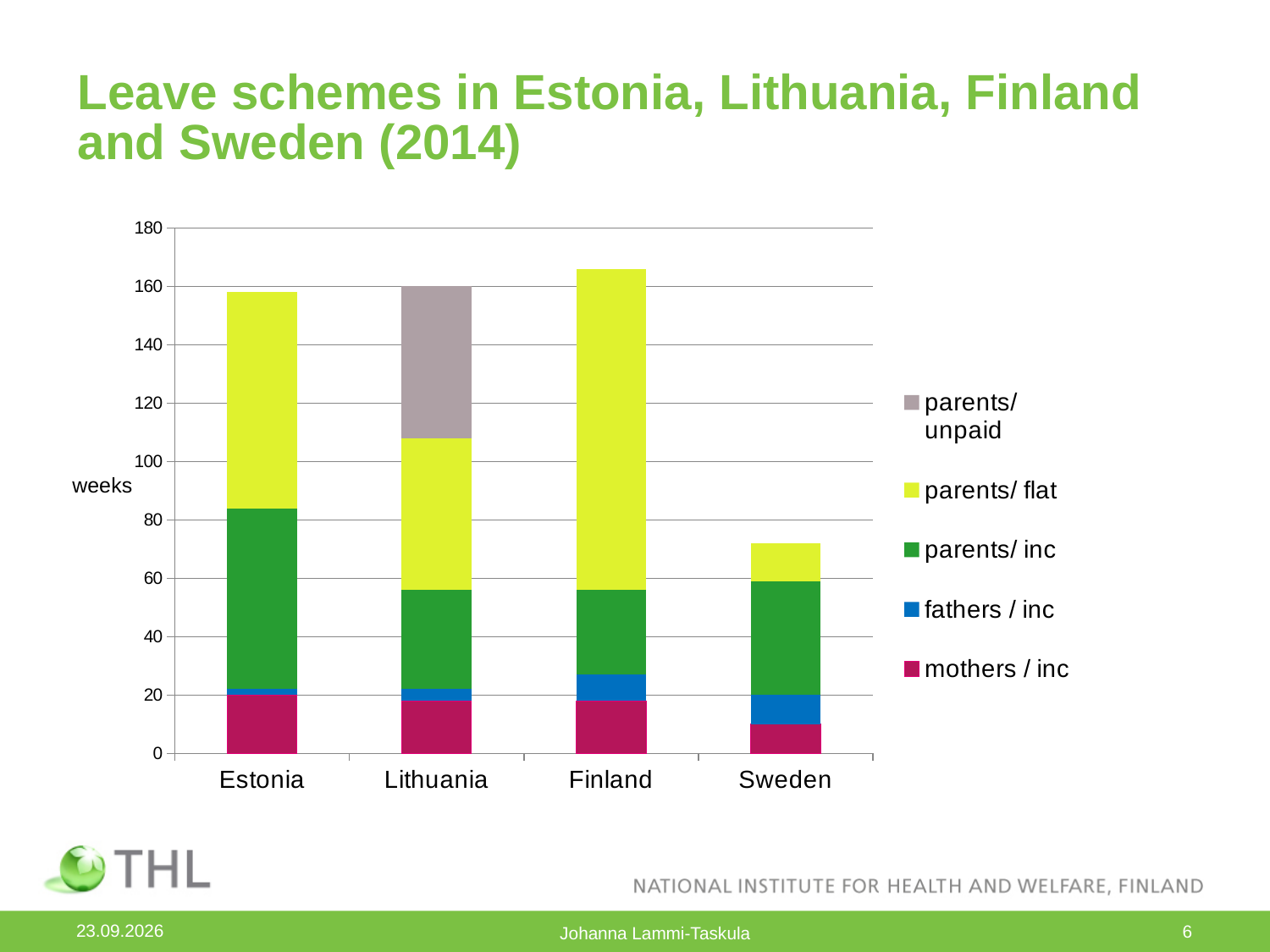
Which country has the tallest stacked bar (the most total weeks of leave)? Finland Which country has the shortest stacked bar (the fewest total weeks of leave)? Sweden What unit is labelled on the vertical axis of the chart? weeks Is the 'parents/ inc' segment larger for Estonia or for Sweden? Estonia What kind of chart is shown on the slide? stacked bar chart Is the total height of the Sweden bar greater or less than 80 weeks? less Which bar is taller in total, Estonia or Sweden? Estonia Which country is the only one with a 'parents/ unpaid' segment in its bar? Lithuania Is the total height of the Finland bar greater or less than 160 weeks? greater Is the total height of the Estonia bar greater or less than 140 weeks? greater How many series does the chart's legend list? 5 How many countries are shown on the x axis of the chart? 4